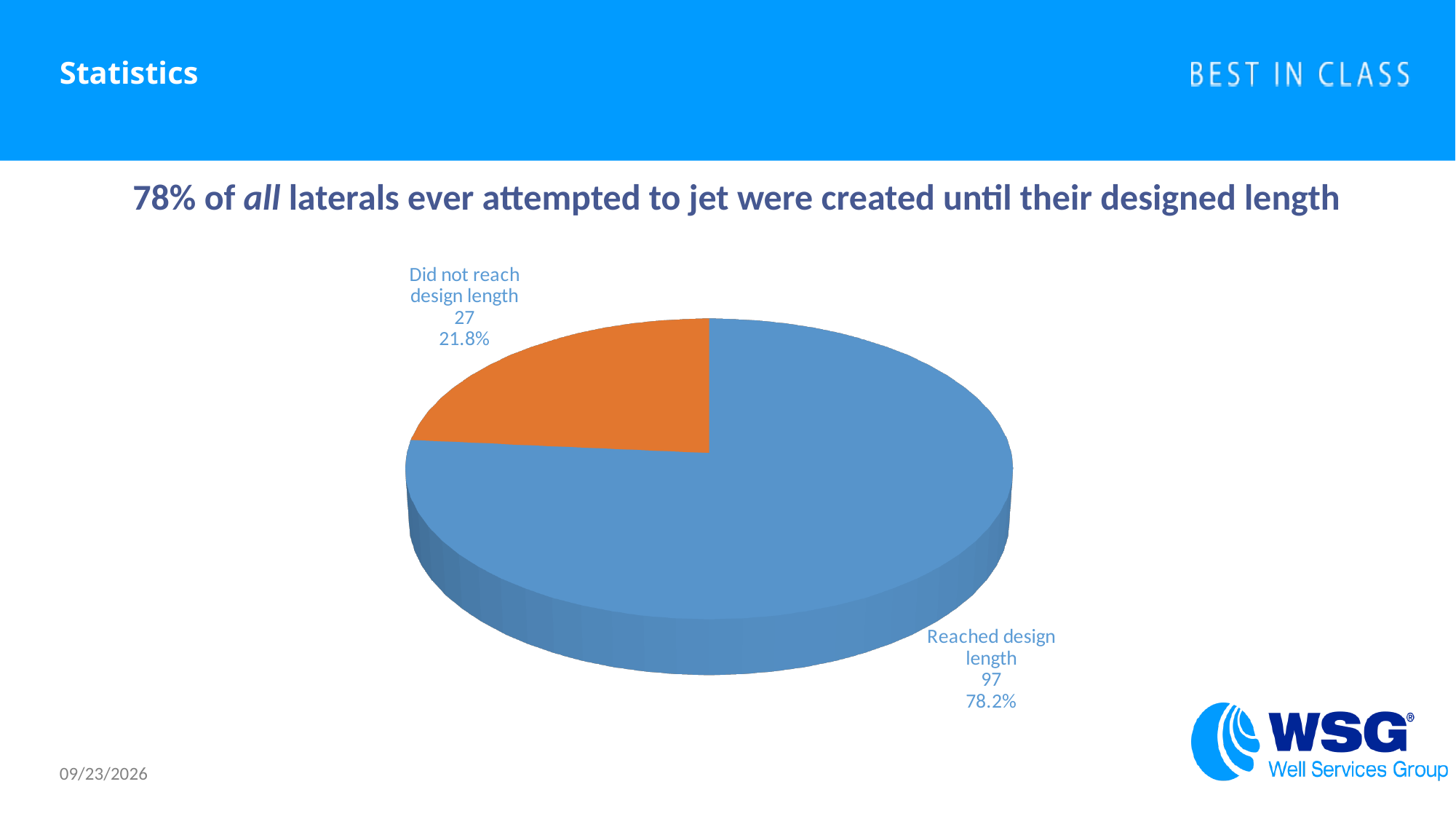
How many laterals reached design length? 97 What is the difference between the number of laterals that reached design length and those that did not? 70 Which is larger: the number of laterals that reached design length or the number that did not? Reached design length What kind of chart is shown on the slide? Pie chart What percentage of laterals did not reach design length? 21.8% How many laterals did not reach design length? 27 What is the total number of laterals represented in the pie chart? 124 What colour is the slice for laterals that did not reach design length? Orange How many categories does the pie chart show? 2 What percentage of laterals reached design length? 78.2% Which category has the smallest slice of the pie? Did not reach design length Which category has the largest slice of the pie? Reached design length